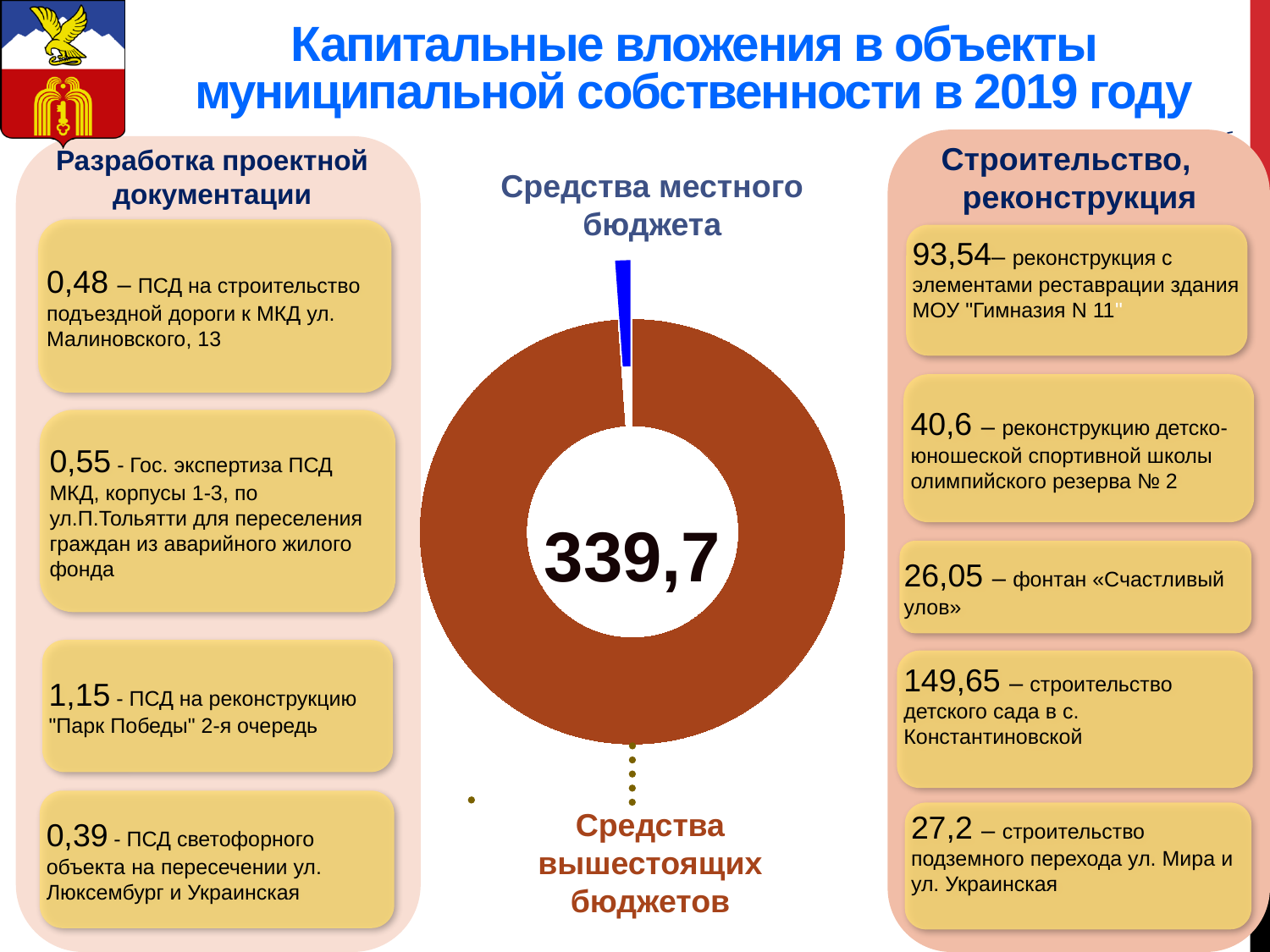
What colour is the slice for Средства вышестоящих бюджетов in the doughnut chart? brown What kind of chart is shown in the centre of the slide? doughnut (pie) chart What number is printed in the centre of the doughnut chart? 339,7 Which category takes the smallest share of the doughnut chart? Средства местного бюджета What colour is the slice for Средства местного бюджета in the doughnut chart? blue Which category takes the largest share of the doughnut chart? Средства вышестоящих бюджетов How many slices does the doughnut chart have? 2 Which slice of the doughnut chart is larger: Средства местного бюджета or Средства вышестоящих бюджетов? Средства вышестоящих бюджетов